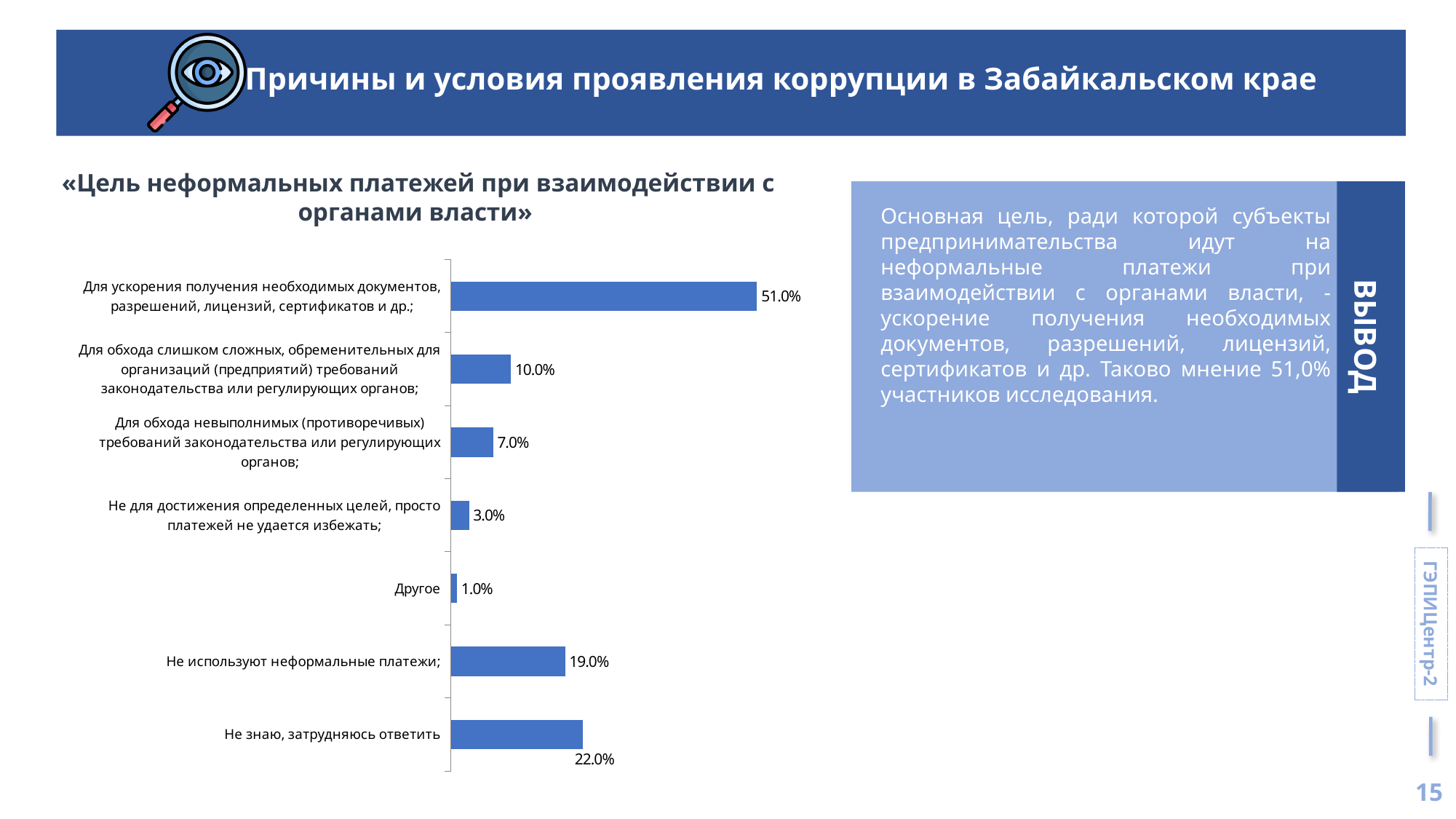
Which is larger: the value for "Для обхода слишком сложных, обременительных для организаций (предприятий) требований законодательства или регулирующих органов" or for "Не для достижения определенных целей, просто платежей не удается избежать"? Для обхода слишком сложных, обременительных для организаций (предприятий) требований законодательства или регулирующих органов What is the value for "Не знаю, затрудняюсь ответить"? 22.0% What type of chart is shown on the slide? bar chart Which category has the highest value? Для ускорения получения необходимых документов, разрешений, лицензий, сертификатов и др. Which category has the lowest value? Другое What is the difference between the values for "Не знаю, затрудняюсь ответить" and "Не используют неформальные платежи"? 3.0% What is the title of the chart? «Цель неформальных платежей при взаимодействии с органами власти» What is the value for "Для ускорения получения необходимых документов, разрешений, лицензий, сертификатов и др."? 51.0% What is the value for "Для обхода невыполнимых (противоречивых) требований законодательства или регулирующих органов"? 7.0% How many categories are shown in the chart? 7 What is the value for "Другое"? 1.0% What is the value for "Не используют неформальные платежи"? 19.0%